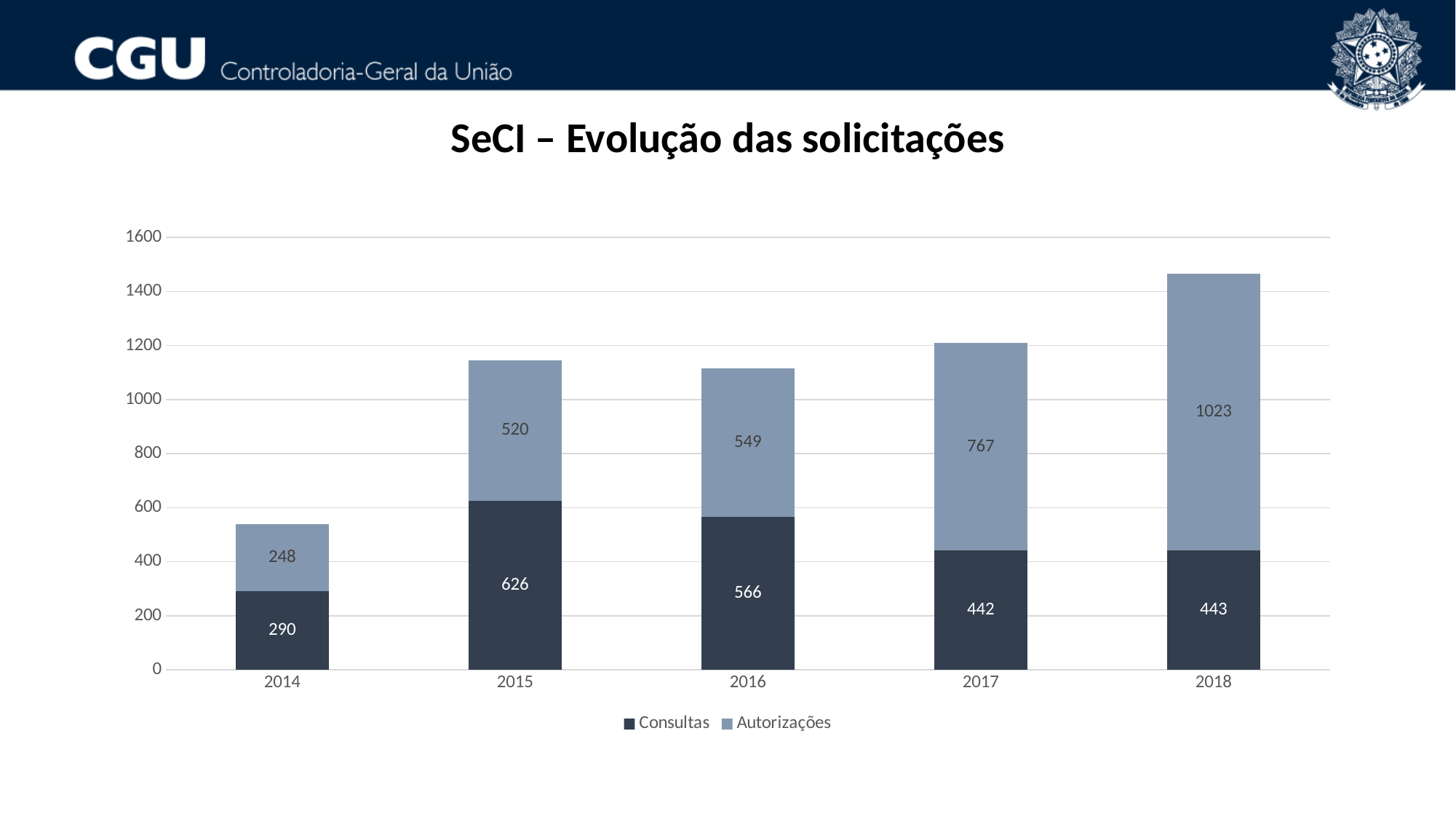
What is the difference between Autorizações and Consultas in 2018? 580 Which year has the highest value for Consultas? 2015 What type of chart is shown on the slide? Stacked bar chart What is the value of Consultas for 2015? 626 How many series does the legend list? 2 Which is larger: Autorizações in 2017 or Autorizações in 2016? Autorizações in 2017 What is the value of Autorizações for 2014? 248 What is the total of the stacked bar for 2014? 538 Which year has the lowest value for Autorizações? 2014 How many years are shown on the x axis? 5 What is the value of Autorizações for 2018? 1023 Is the total stacked value for 2018 greater or less than 1400? greater